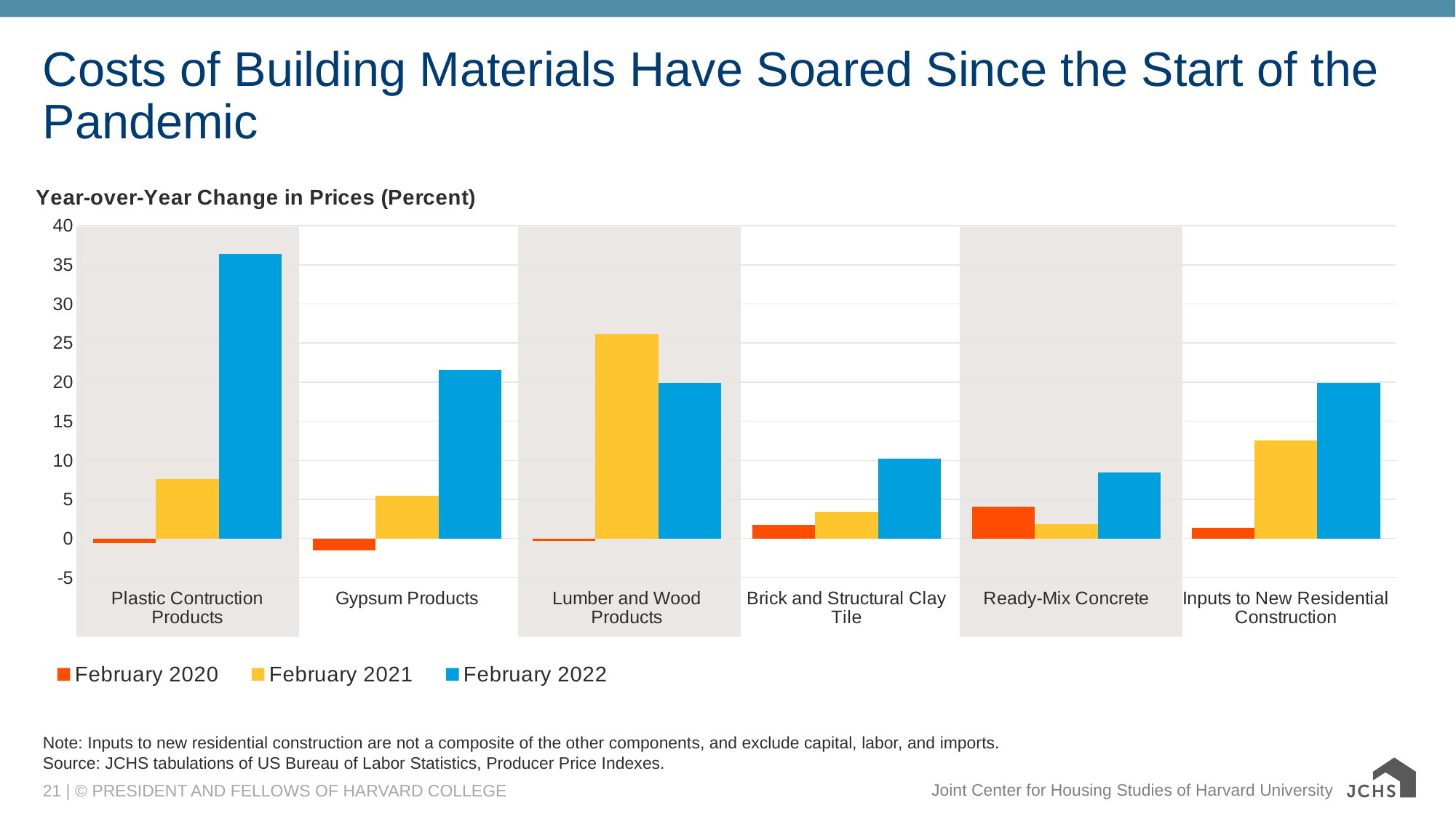
Which category has the highest February 2022 value? Plastic Contruction Products For Ready-Mix Concrete, which is larger: the February 2020 value or the February 2021 value? February 2020 How many series does the legend list? 3 For Lumber and Wood Products, which is larger: the February 2021 value or the February 2022 value? February 2021 Which category has the highest February 2020 value? Ready-Mix Concrete What kind of chart is shown on the slide? Bar chart Which category has the lowest February 2020 value? Gypsum Products Which category has the highest February 2021 value? Lumber and Wood Products Is the February 2021 value for Inputs to New Residential Construction greater or less than 10? greater How many material categories are shown on the x axis? 6 Is the February 2022 value for Plastic Contruction Products greater or less than 35? greater Is the February 2021 value for Lumber and Wood Products greater or less than 25? greater